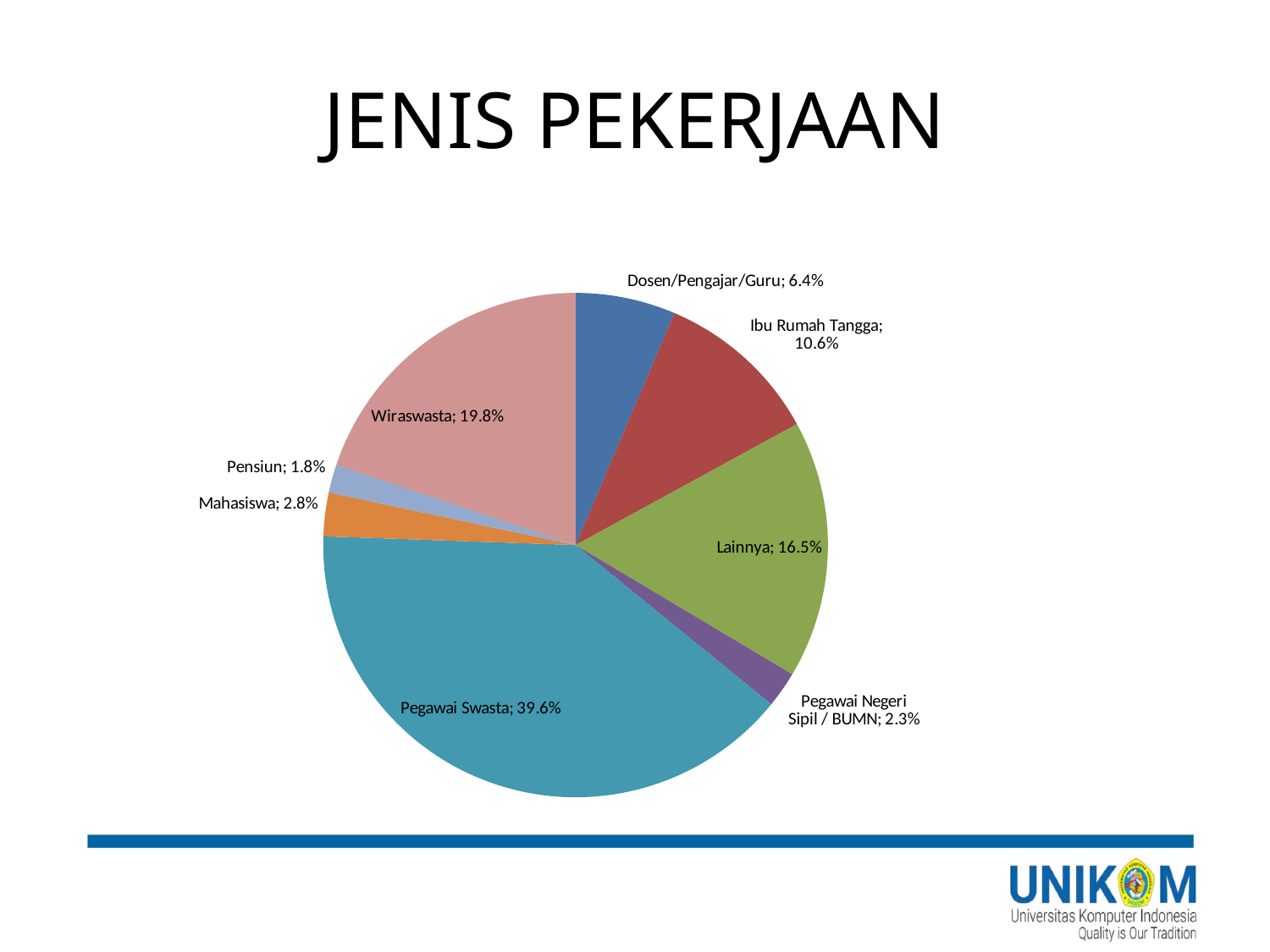
What is the share for Ibu Rumah Tangga? 10.6% What is the title of the slide? JENIS PEKERJAAN What is the difference between the shares of Lainnya and Dosen/Pengajar/Guru? 10.1% Which category has the largest slice? Pegawai Swasta Which is larger, the share for Mahasiswa or the share for Pensiun? Mahasiswa Which category has the smallest slice? Pensiun What is the share for Wiraswasta? 19.8% What kind of chart is shown on the slide? pie chart What is the share for Pegawai Swasta? 39.6% What is the share for Pegawai Negeri Sipil / BUMN? 2.3% What is the difference between the shares of Pegawai Swasta and Wiraswasta? 19.8% How many categories are shown in the pie chart? 8